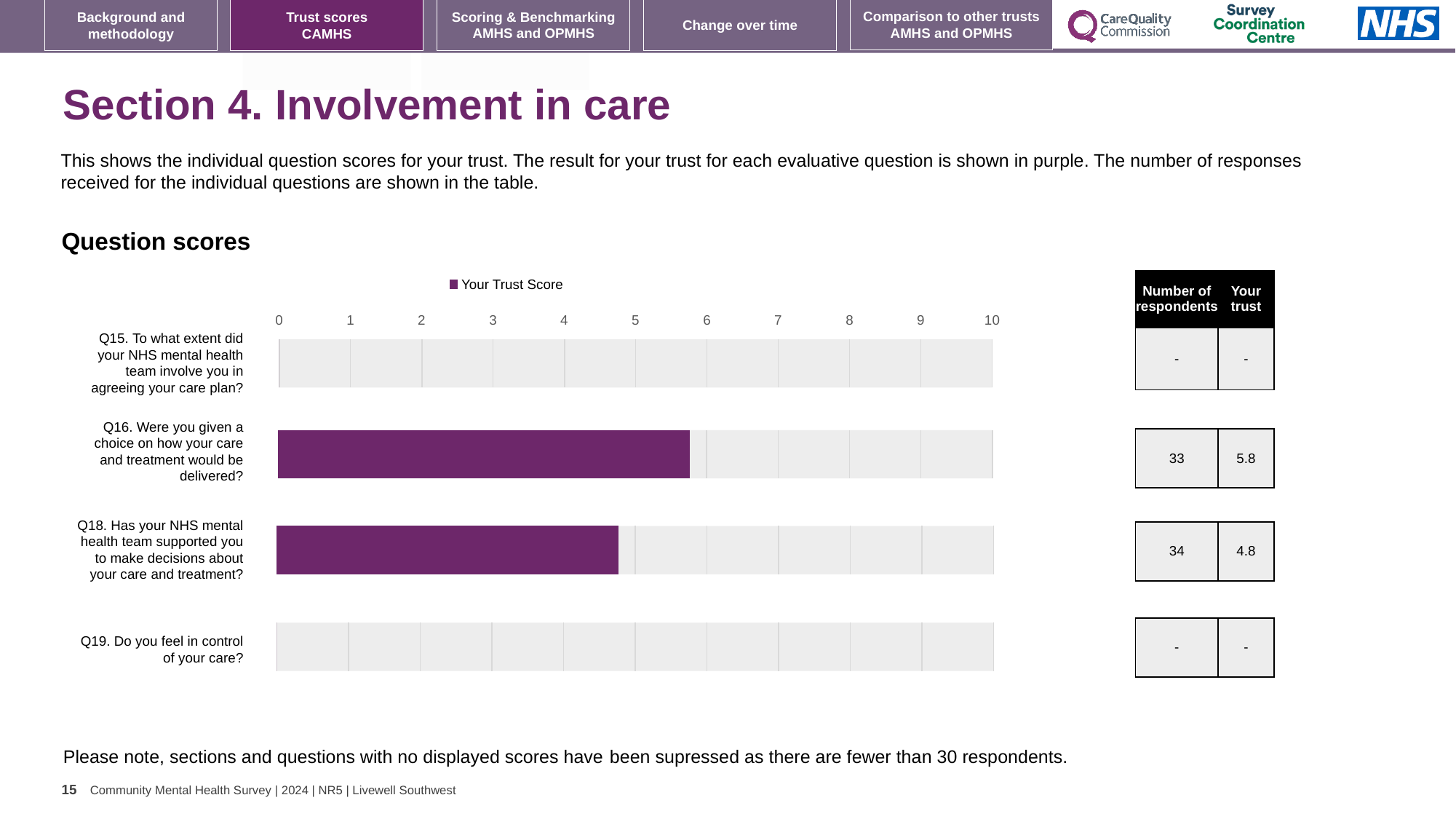
How many series does the chart legend list? 1 Which has a larger Your Trust Score, Q16 or Q18? Q16 Which question has the highest displayed Your Trust Score? Q16 Is the Your Trust Score for Q18 greater or less than 5? less What is the Your Trust Score for Q18 (Has your NHS mental health team supported you to make decisions about your care and treatment?)? 4.8 What is the difference between the Your Trust Score for Q16 and Q18? 1.0 How many questions (categories) are listed on the chart? 4 What type of chart is shown under Question scores? Bar chart How many respondents answered Q18 according to the table next to the chart? 34 What is the Your Trust Score for Q16 (Were you given a choice on how your care and treatment would be delivered?)? 5.8 How many respondents answered Q16 according to the table next to the chart? 33 Is the Your Trust Score for Q16 greater or less than 5? greater